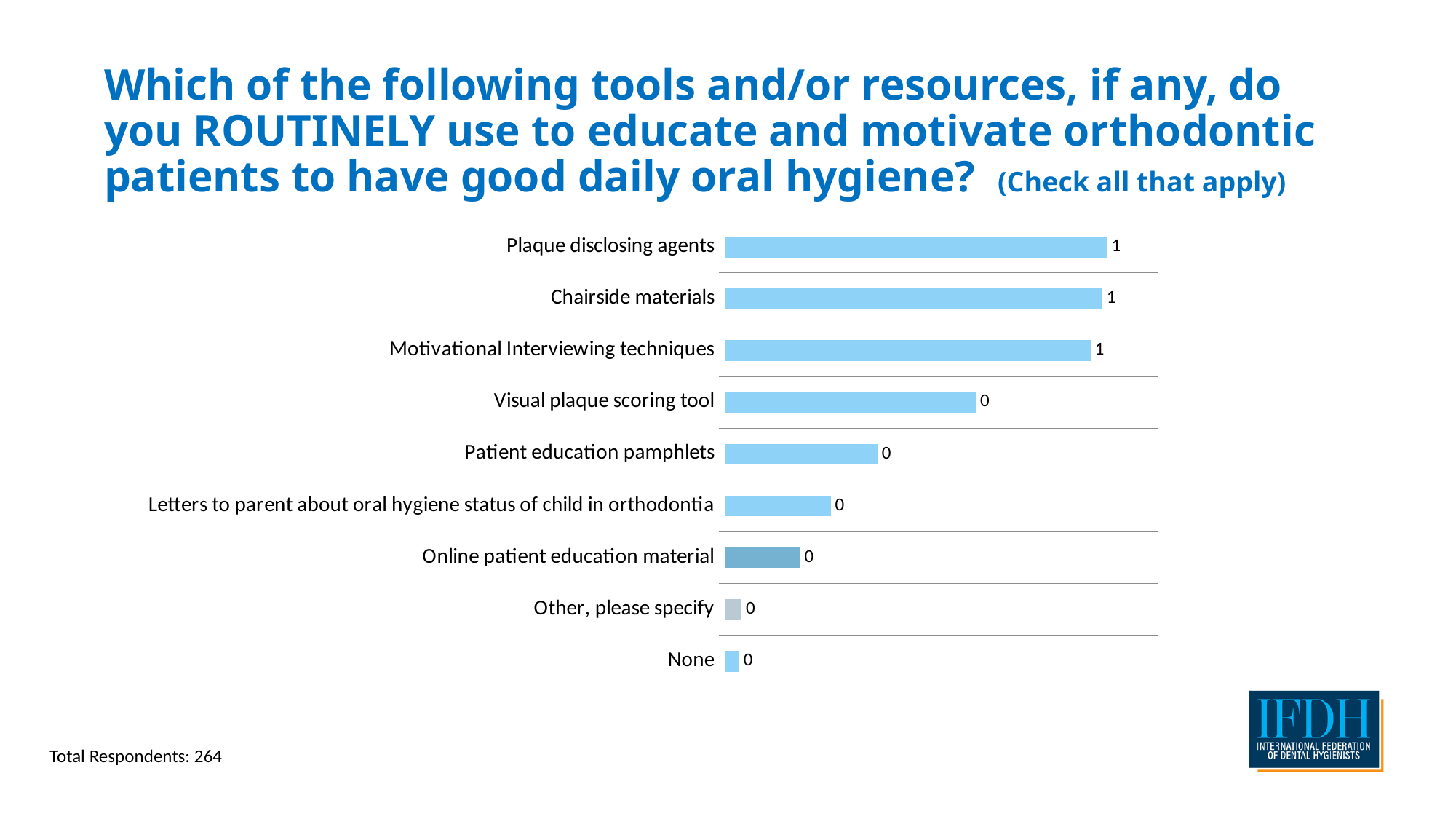
What data label is shown for Chairside materials? 1 What data label is shown for None? 0 How many categories (tools/resources) are listed in the chart? 9 How many total respondents are noted on the slide? 264 What kind of chart is shown on the slide? bar chart Which bar is longer: Patient education pamphlets or Letters to parent about oral hygiene status of child in orthodontia? Patient education pamphlets Which bar is longer: Visual plaque scoring tool or Patient education pamphlets? Visual plaque scoring tool Which bar is longer: Online patient education material or Other, please specify? Online patient education material What data label is shown for Visual plaque scoring tool? 0 What data label is shown for Plaque disclosing agents? 1 What data label is shown for Motivational Interviewing techniques? 1